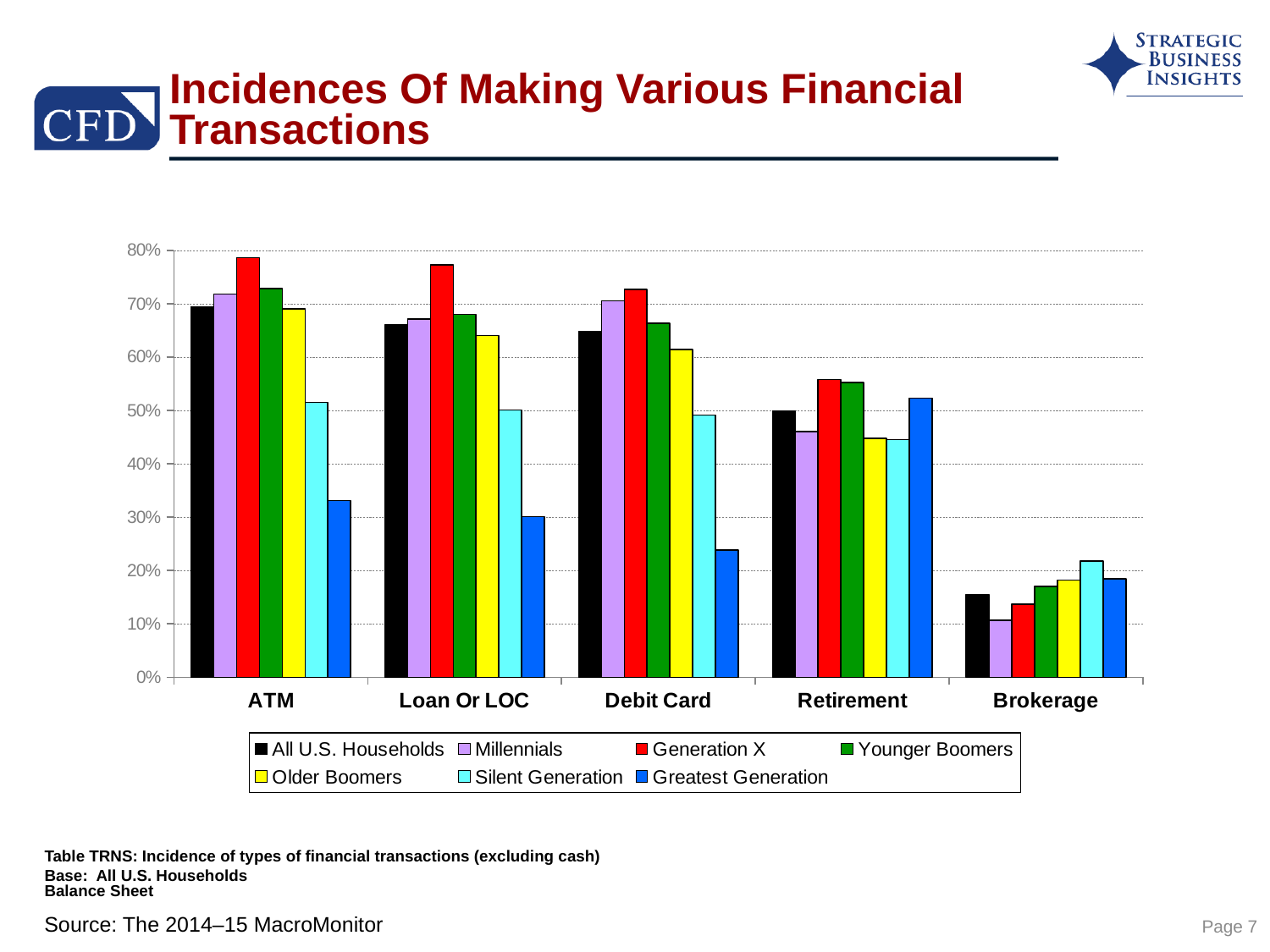
Is the value for Greatest Generation in the ATM category greater or less than 40%? less What colour represents Generation X in the legend? Red Do the All U.S. Households values rise or fall moving from ATM to Brokerage along the x axis? fall How many series does the legend list? 7 Which series has the lowest value in the Brokerage category? Millennials Is the value for Silent Generation in the Loan Or LOC category greater or less than 60%? less How many transaction categories are shown on the x axis? 5 What kind of chart is shown on the slide? Bar chart Is the value for Generation X in the ATM category greater or less than 70%? greater For Greatest Generation, which is larger: the Loan Or LOC value or the Debit Card value? Loan Or LOC Which series has the highest value in the ATM category? Generation X Which series has the lowest value in the Loan Or LOC category? Greatest Generation